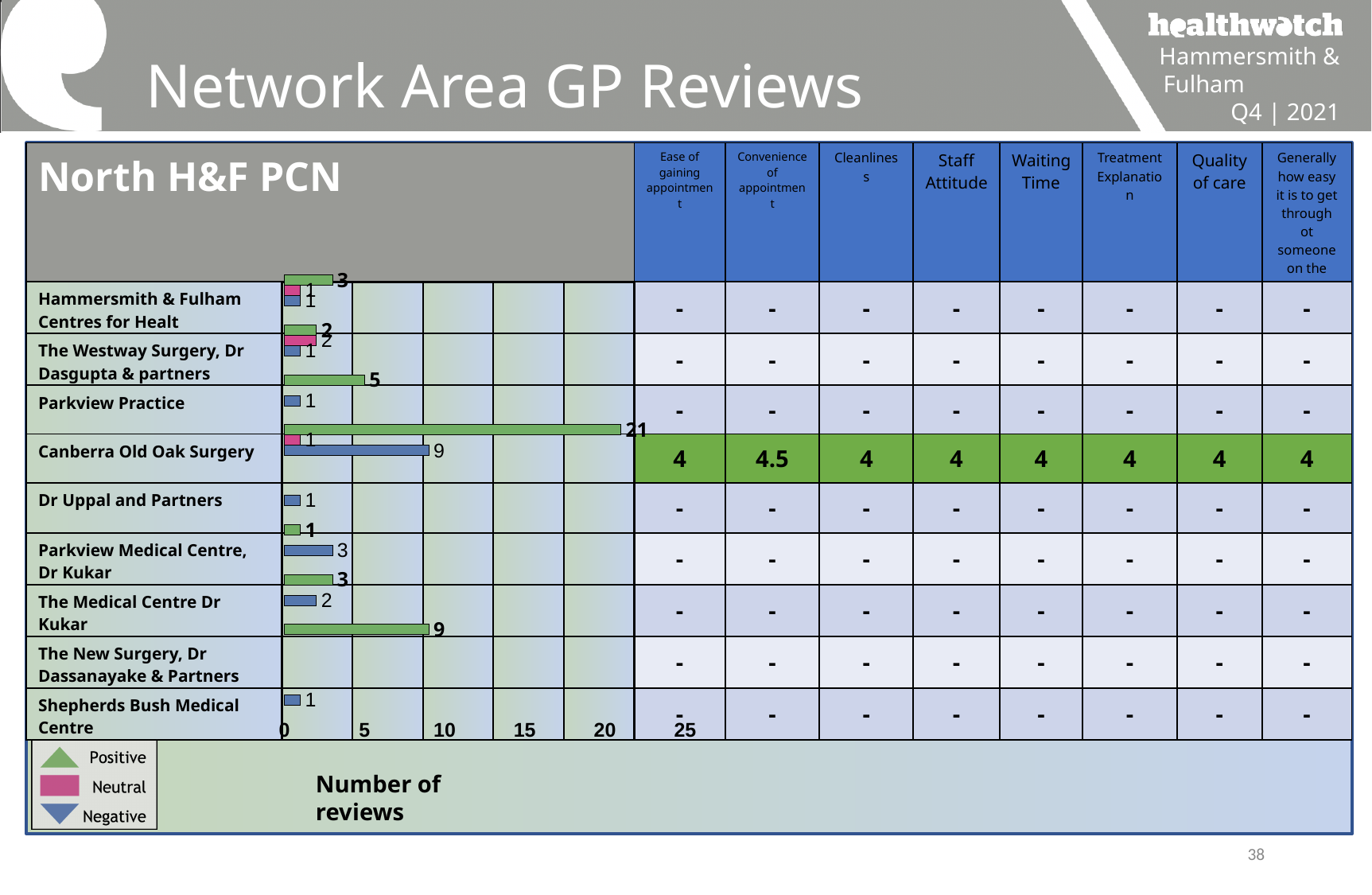
Is the number of positive reviews for Canberra Old Oak Surgery greater or less than 20? greater What is the label of the chart's horizontal axis? Number of reviews What are the three series named in the chart legend? Positive, Neutral, Negative How many negative reviews does Parkview Medical Centre, Dr Kukar have? 3 How many GP practices are listed as categories in the chart? 9 What is the difference between the positive and negative review counts for Canberra Old Oak Surgery? 12 How many series does the chart legend list? 3 How many positive reviews does Canberra Old Oak Surgery have? 21 Which has more negative reviews, Canberra Old Oak Surgery or Parkview Medical Centre, Dr Kukar? Canberra Old Oak Surgery What kind of chart is shown on the slide? bar chart How many negative reviews does Canberra Old Oak Surgery have? 9 Which practice has the highest number of positive reviews? Canberra Old Oak Surgery